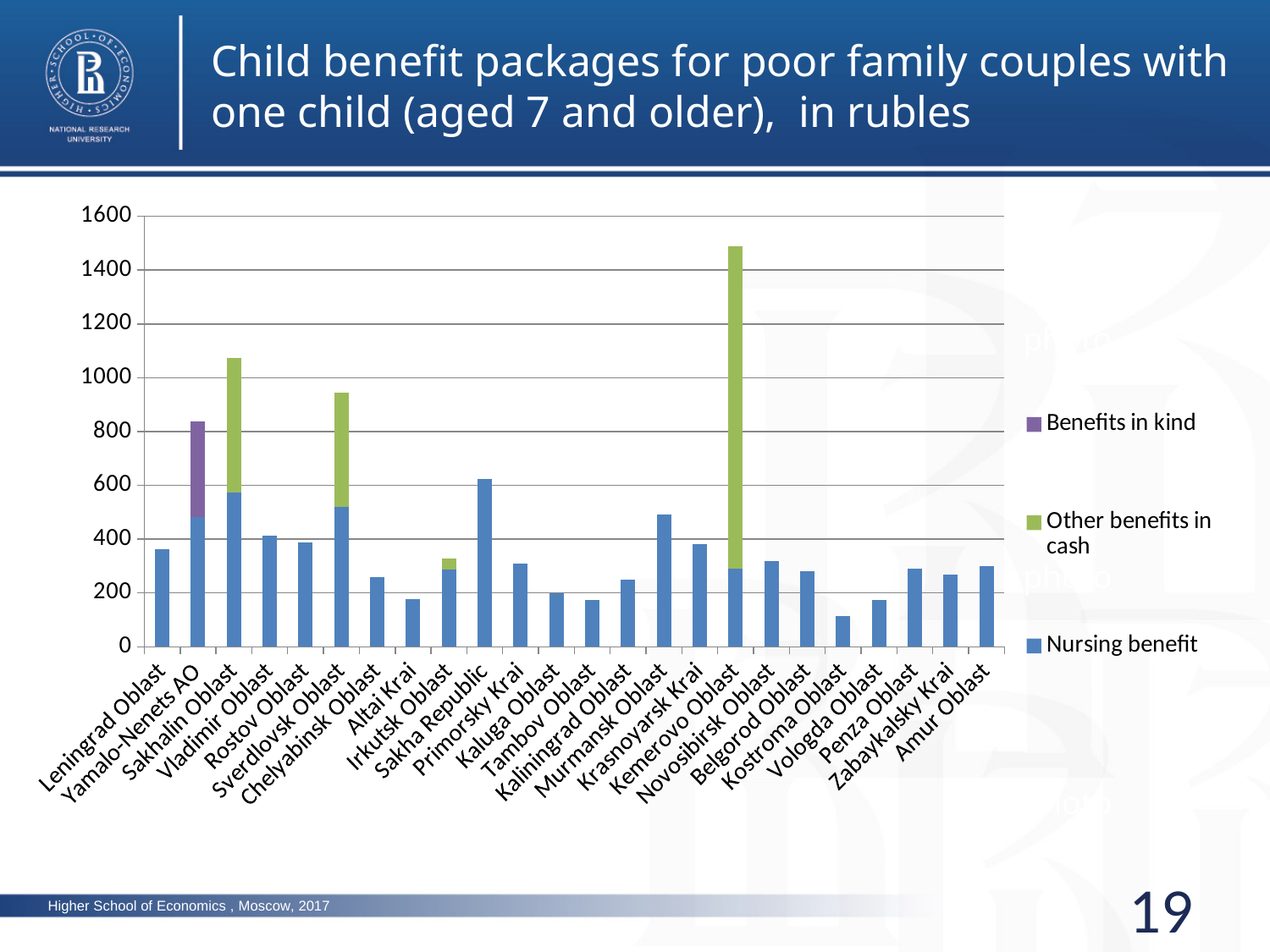
Which region has the highest total child benefit package? Kemerovo Oblast Is the total value for Kemerovo Oblast greater or less than 1400? greater How many regions are shown on the x axis of the chart? 24 Which has a larger value, Murmansk Oblast or Krasnoyarsk Krai? Murmansk Oblast Is the total value for Sakhalin Oblast greater or less than 1000? greater Which has a larger total value, Sakhalin Oblast or Sverdlovsk Oblast? Sakhalin Oblast How many series does the legend list? 3 Which region has the lowest total child benefit package? Kostroma Oblast Is the value for Sverdlovsk Oblast greater or less than 800? greater Which region is the only one with a 'Benefits in kind' segment in its bar? Yamalo-Nenets AO What kind of chart is shown on the slide? Stacked bar chart